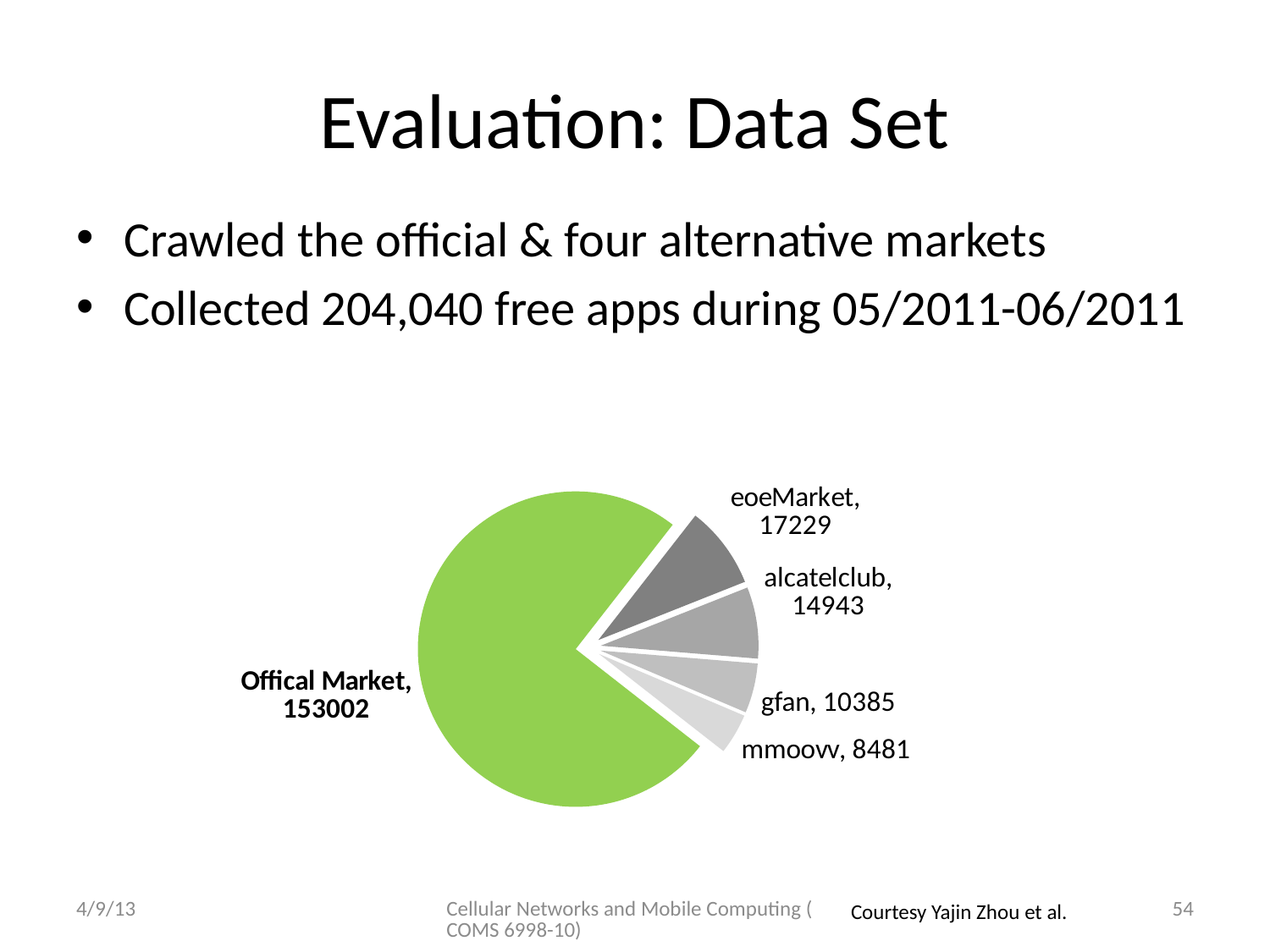
Which is larger, the value for alcatelclub or the value for gfan? alcatelclub What is the total of all slices in the pie chart? 204040 What is the value for mmoovv in the pie chart? 8481 What is the difference between the values for eoeMarket and alcatelclub? 2286 What is the difference between the values for gfan and mmoovv? 1904 What type of chart is shown on the slide? pie chart What is the value for alcatelclub in the pie chart? 14943 Which market has the smallest slice in the pie chart? mmoovv What is the value for gfan in the pie chart? 10385 How many slices does the pie chart have? 5 Which market has the largest slice in the pie chart? Offical Market What is the value for eoeMarket in the pie chart? 17229